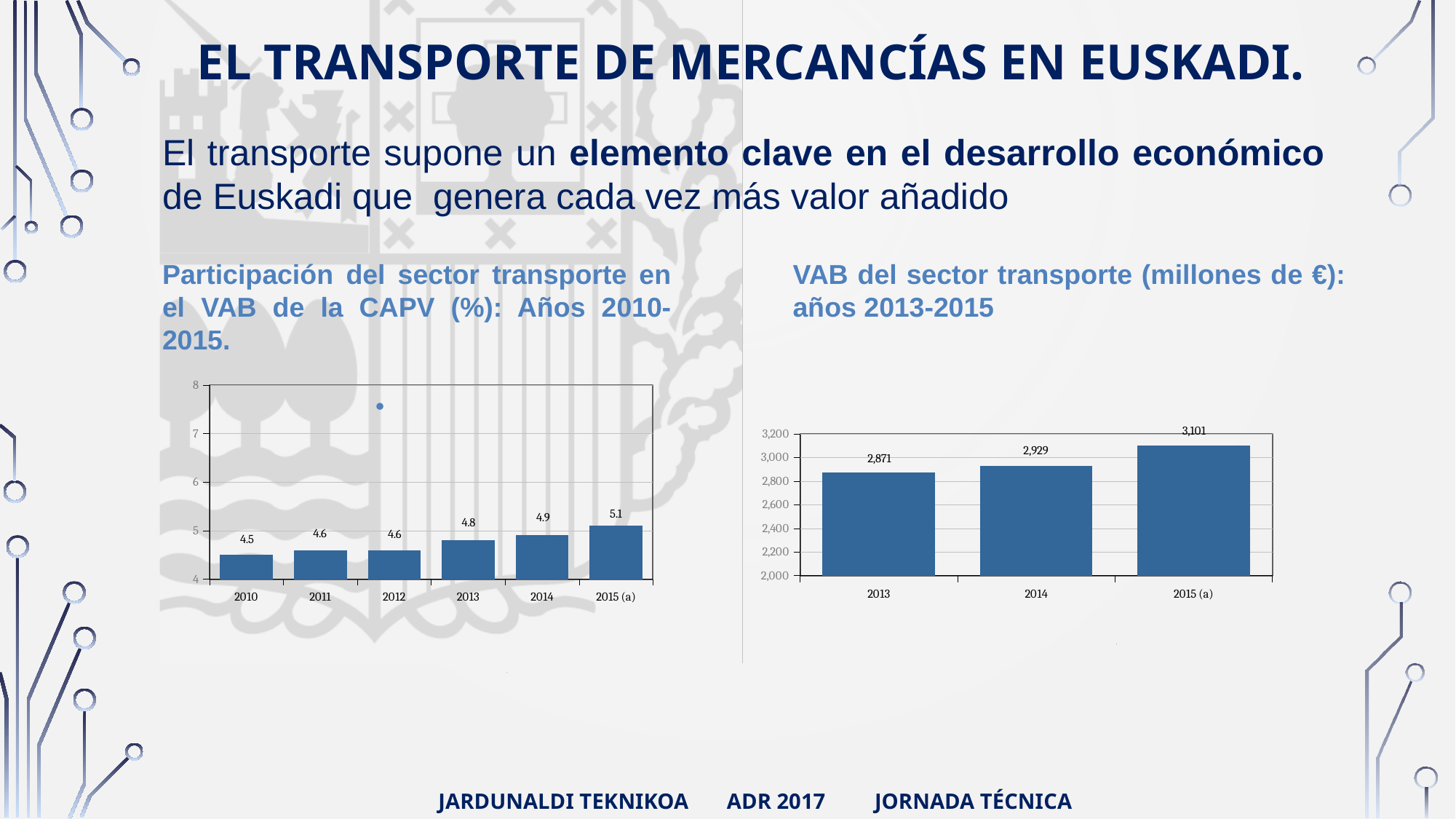
In the left chart (Participación del sector transporte en el VAB de la CAPV), what is the value for 2013? 4.8 In the left chart (Participación del sector transporte en el VAB de la CAPV), what is the value for 2010? 4.5 In the right chart (VAB del sector transporte), is the value for 2013 greater or less than 3,000? less In the left chart (Participación del sector transporte en el VAB de la CAPV), how many years are shown on the x axis? 6 In the left chart (Participación del sector transporte en el VAB de la CAPV), which year has the lowest value? 2010 In the right chart (VAB del sector transporte), what is the value for 2015 (a)? 3,101 In the right chart (VAB del sector transporte), what is the value for 2014? 2,929 In the left chart (Participación del sector transporte en el VAB de la CAPV), do the values generally rise or fall from 2010 to 2015 (a)? rise In the left chart (Participación del sector transporte en el VAB de la CAPV), which year has the highest value? 2015 (a) What kind of chart is the right chart (VAB del sector transporte)? bar chart In the left chart (Participación del sector transporte en el VAB de la CAPV), what is the difference between the values for 2015 (a) and 2010? 0.6 In the right chart (VAB del sector transporte), what is the difference between the values for 2015 (a) and 2013? 230